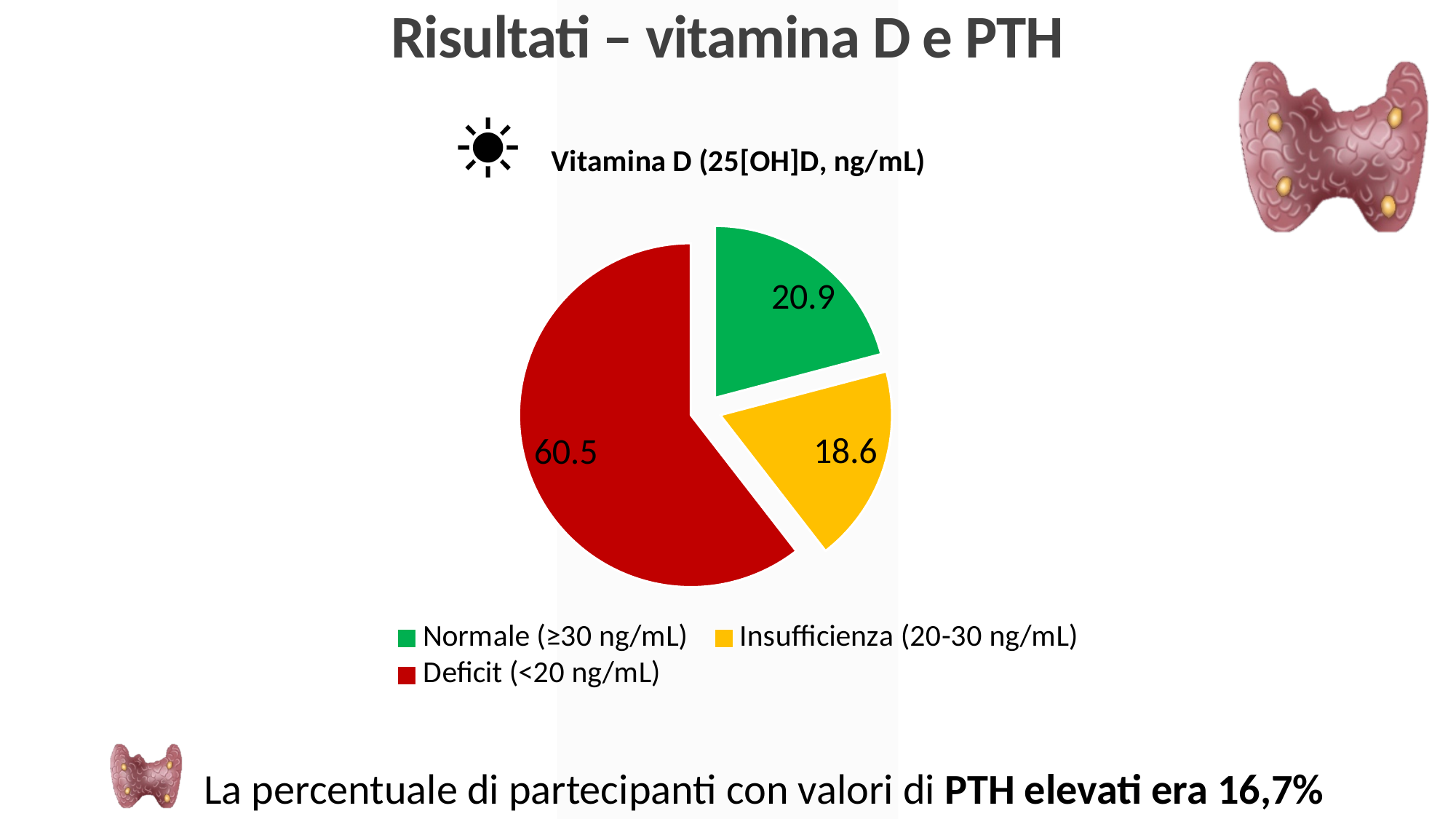
What type of chart is shown on the slide? pie chart Which is larger, the Normale (≥30 ng/mL) slice or the Insufficienza (20-30 ng/mL) slice? Normale (≥30 ng/mL) What is the difference between the Deficit (<20 ng/mL) value and the Normale (≥30 ng/mL) value? 39.6 What is the value for the Insufficienza (20-30 ng/mL) slice? 18.6 What colour is the Deficit (<20 ng/mL) slice? red How many slices does the pie chart have? 3 How many entries does the legend list? 3 What is the value for the Normale (≥30 ng/mL) slice? 20.9 What is the value for the Deficit (<20 ng/mL) slice? 60.5 Which category has the smallest slice? Insufficienza (20-30 ng/mL) Which category has the largest slice? Deficit (<20 ng/mL) What is the title of the pie chart? Vitamina D (25[OH]D, ng/mL)